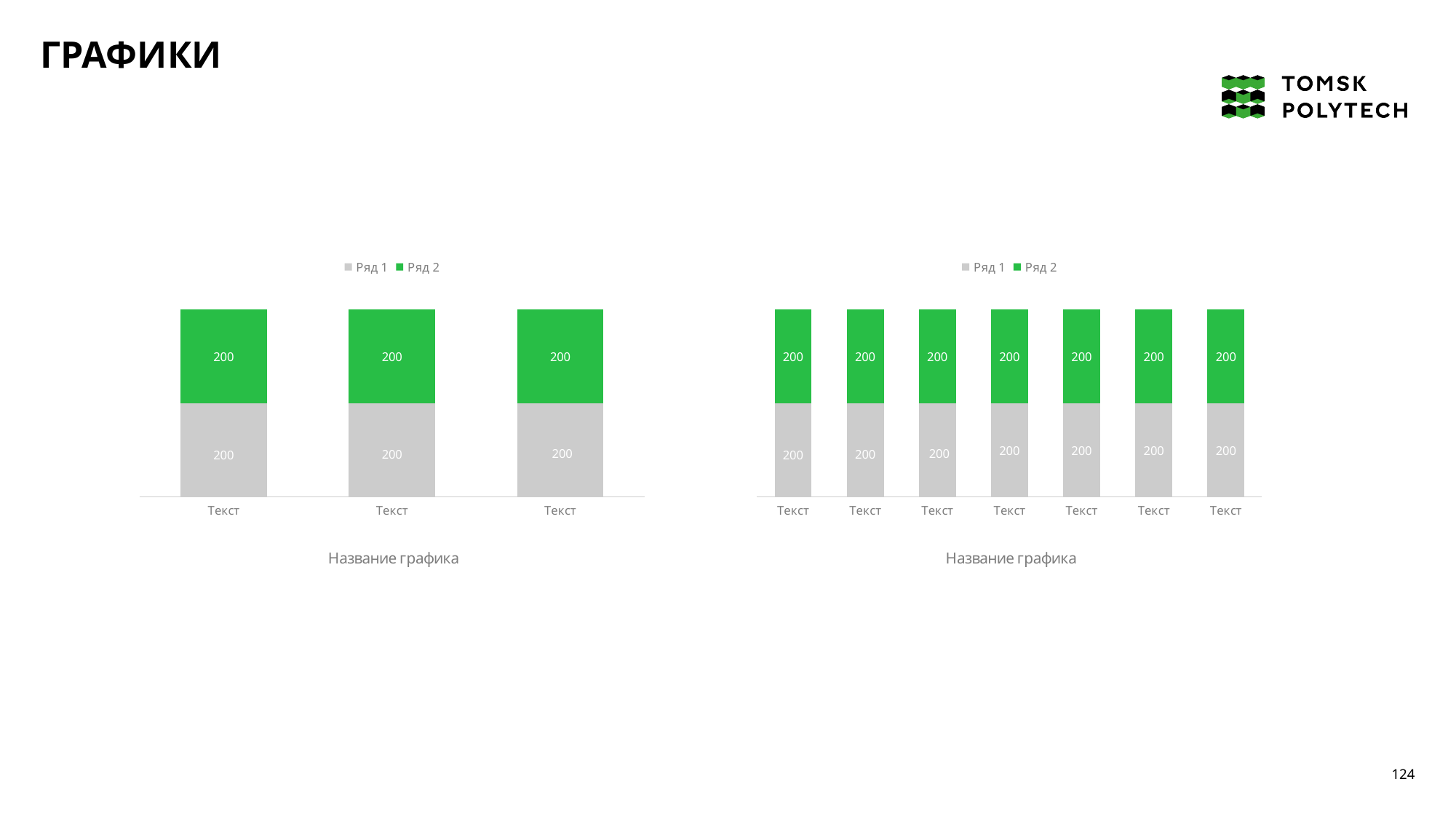
What kind of chart is the chart on the left side of the slide? Stacked bar chart How many bars does the chart on the right side of the slide have? 7 How many bars does the chart on the left side of the slide have? 3 In the left chart, what is the total of the middle stacked bar? 400 How many series does the legend of the left chart list? 2 In the left chart, what is the difference between the Ряд 1 and Ряд 2 values of the third bar? 0 In the right chart, do the Ряд 1 values rise, fall, or stay the same across the bars from left to right? Stay the same Which colour represents Ряд 2 in the right chart? Green What are the series names in the legend of the right chart? Ряд 1 and Ряд 2 In the right chart, what is the total of the fourth stacked bar? 400 In the left chart, what is the value of Ряд 2 for the first (leftmost) bar? 200 In the right chart, what is the value of Ряд 1 for the last (rightmost) bar? 200